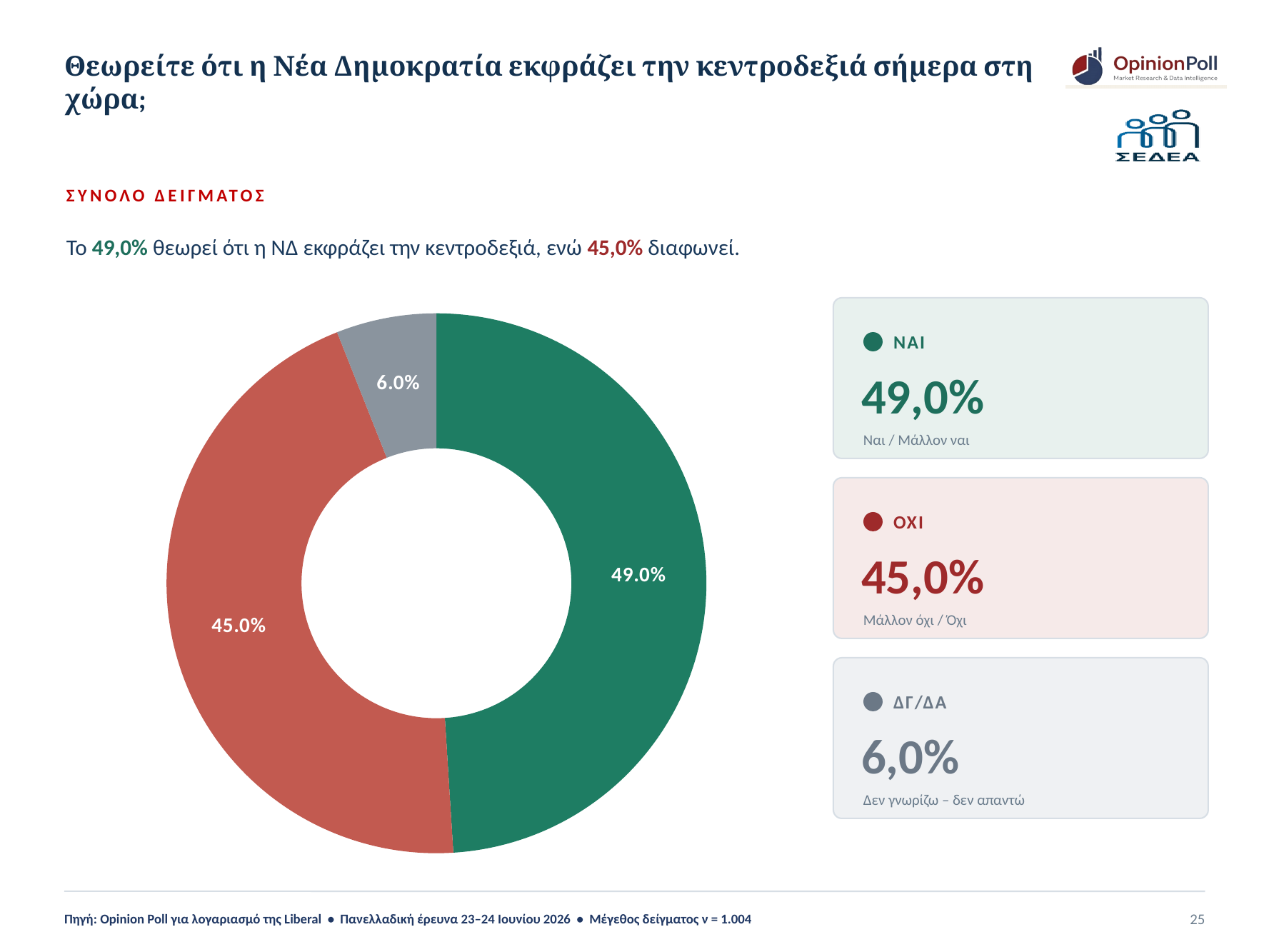
What share of the donut chart is labelled ΔΓ/ΔΑ? 6.0% How many slices does the donut chart have? 3 Which category has the smallest slice in the donut chart? ΔΓ/ΔΑ Which category has the largest slice in the donut chart? ΝΑΙ What colour is the ΝΑΙ slice in the donut chart? Green Which is larger, the ΟΧΙ slice or the ΔΓ/ΔΑ slice? ΟΧΙ What is the combined share of the ΝΑΙ and ΟΧΙ slices? 94.0% What share of the donut chart is labelled ΝΑΙ? 49.0% What share of the donut chart is labelled ΟΧΙ? 45.0% What is the difference in percentage points between the ΝΑΙ and ΟΧΙ slices? 4.0 percentage points What kind of chart is shown on the slide? Donut (pie) chart What colour is the ΟΧΙ slice in the donut chart? Red